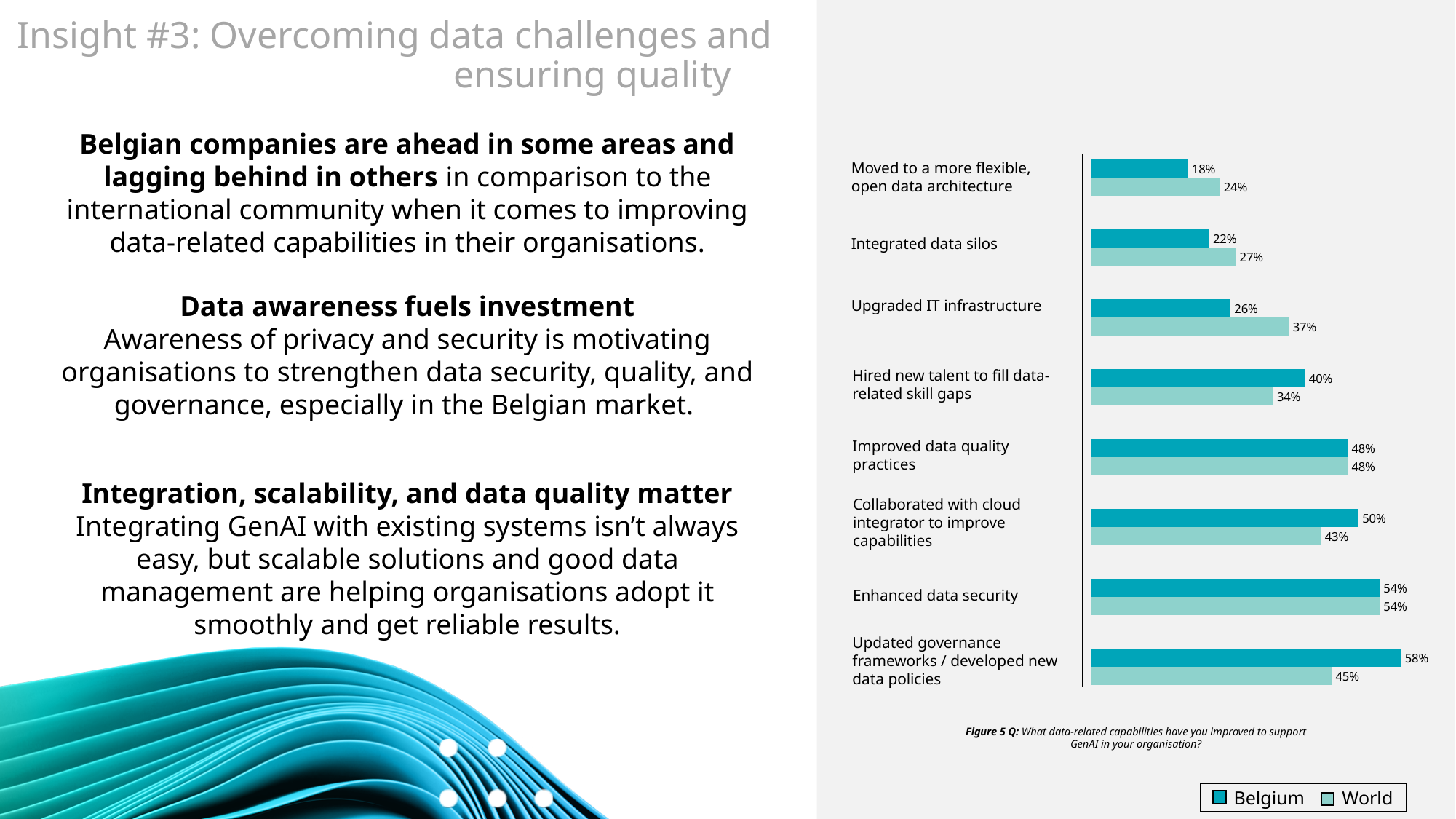
What is the Belgium value for "Enhanced data security"? 54% What is the World value for "Updated governance frameworks / developed new data policies"? 45% For "Collaborated with cloud integrator to improve capabilities", which is larger, the Belgium value or the World value? Belgium What are the two series named in the legend? Belgium and World How many categories are shown in the chart? 8 What kind of chart is shown on the slide? Bar chart What is the Belgium value for "Upgraded IT infrastructure"? 26% What is the difference between the Belgium and World values for "Upgraded IT infrastructure"? 11% Which category has the highest Belgium value? Updated governance frameworks / developed new data policies What is the World value for "Hired new talent to fill data-related skill gaps"? 34% How many series does the legend list? 2 Which category has the lowest World value? Moved to a more flexible, open data architecture